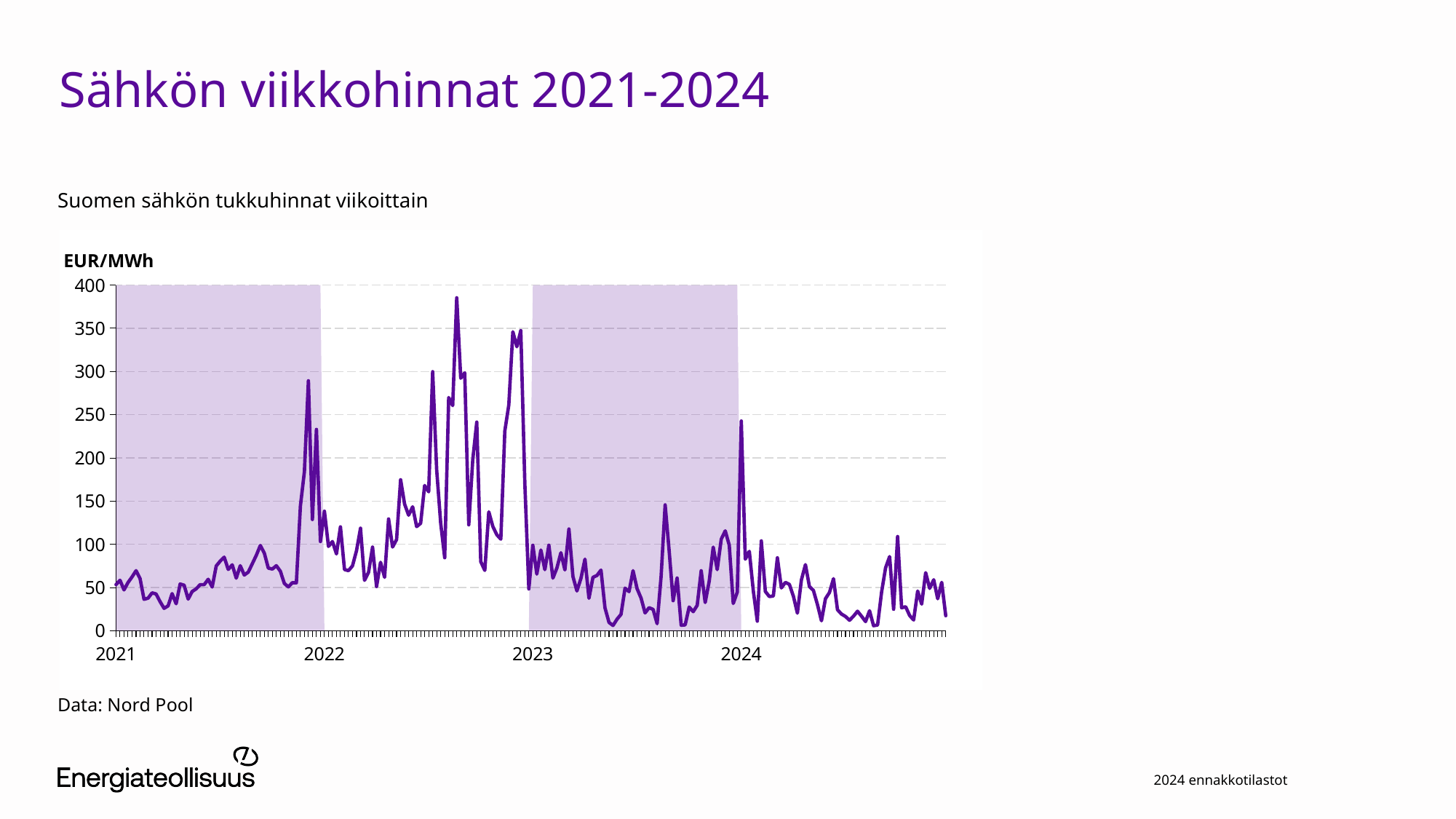
What is the highest value shown on the y axis of the chart? 400 Is the highest weekly price in 2022 greater or less than 350 EUR/MWh? greater What kind of chart is shown on the slide? line chart What unit is shown on the y axis of the chart? EUR/MWh How many year labels are shown on the x axis of the chart? 4 Is the weekly price at the start of 2021 greater or less than 100 EUR/MWh? less In which year does the weekly price reach its highest peak? 2022 Is the highest weekly price in 2021 greater or less than 250 EUR/MWh? greater Which year has the higher peak weekly price, 2022 or 2024? 2022 What is the title of the slide's chart? Sähkön viikkohinnat 2021-2024